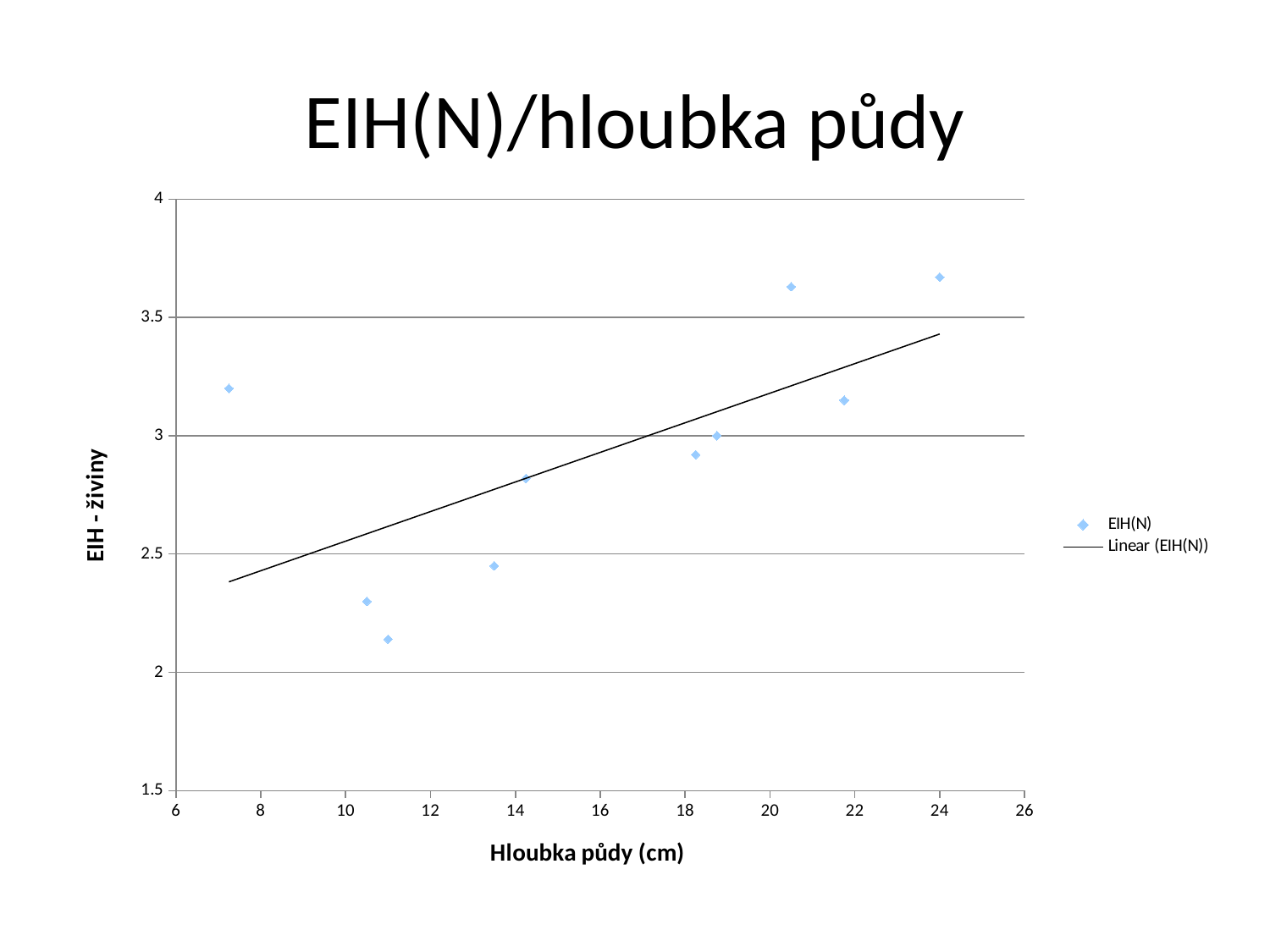
What kind of chart is shown on the slide? scatter chart Does the linear trendline rise or fall as soil depth (Hloubka půdy) increases? rises How many data points are plotted in the chart? 10 Is the EIH(N) value for the point at a soil depth of about 7 cm greater or less than 3? greater What is the label of the x axis? Hloubka půdy (cm) Is the EIH(N) value for the point at a soil depth of about 13.5 cm greater or less than 2.5? less Is the EIH(N) value for the point at a soil depth of about 24 cm greater or less than 3.5? greater What is the title of the chart? EIH(N)/hloubka půdy Which has the higher EIH(N) value: the point at a soil depth of about 7 cm or the point at about 10.5 cm? the point at about 7 cm How many entries does the chart legend list? 2